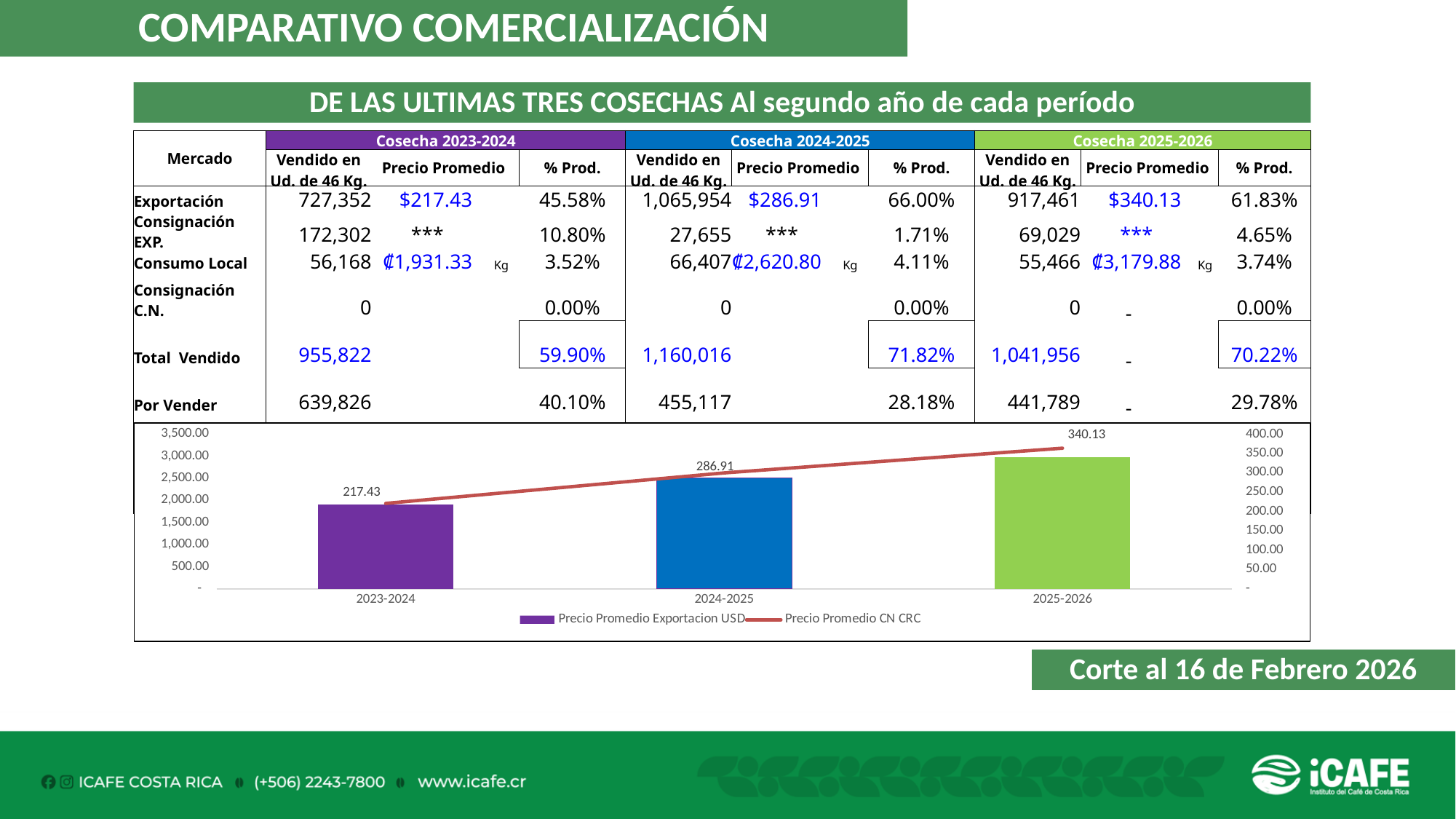
Which harvest period has the highest Precio Promedio Exportacion USD bar? 2025-2026 What is the Precio Promedio Exportacion USD value for 2025-2026 in the chart? 340.13 Is the Precio Promedio CN CRC line value for 2023-2024 greater or less than 1,500.00 on the left axis? greater What is the Precio Promedio Exportacion USD value for 2023-2024 in the chart? 217.43 Which is larger, the Precio Promedio Exportacion USD bar for 2024-2025 or for 2025-2026? 2025-2026 What is the difference between the Precio Promedio Exportacion USD values for 2025-2026 and 2023-2024? 122.70 Is the Precio Promedio CN CRC line value for 2025-2026 greater or less than 2,500.00 on the left axis? greater Which harvest period has the lowest Precio Promedio Exportacion USD bar? 2023-2024 What is the Precio Promedio Exportacion USD value for 2024-2025 in the chart? 286.91 How many harvest periods are shown on the x axis of the chart? 3 How many series does the chart legend list? 2 What is the difference between the Precio Promedio Exportacion USD values for 2024-2025 and 2023-2024? 69.48